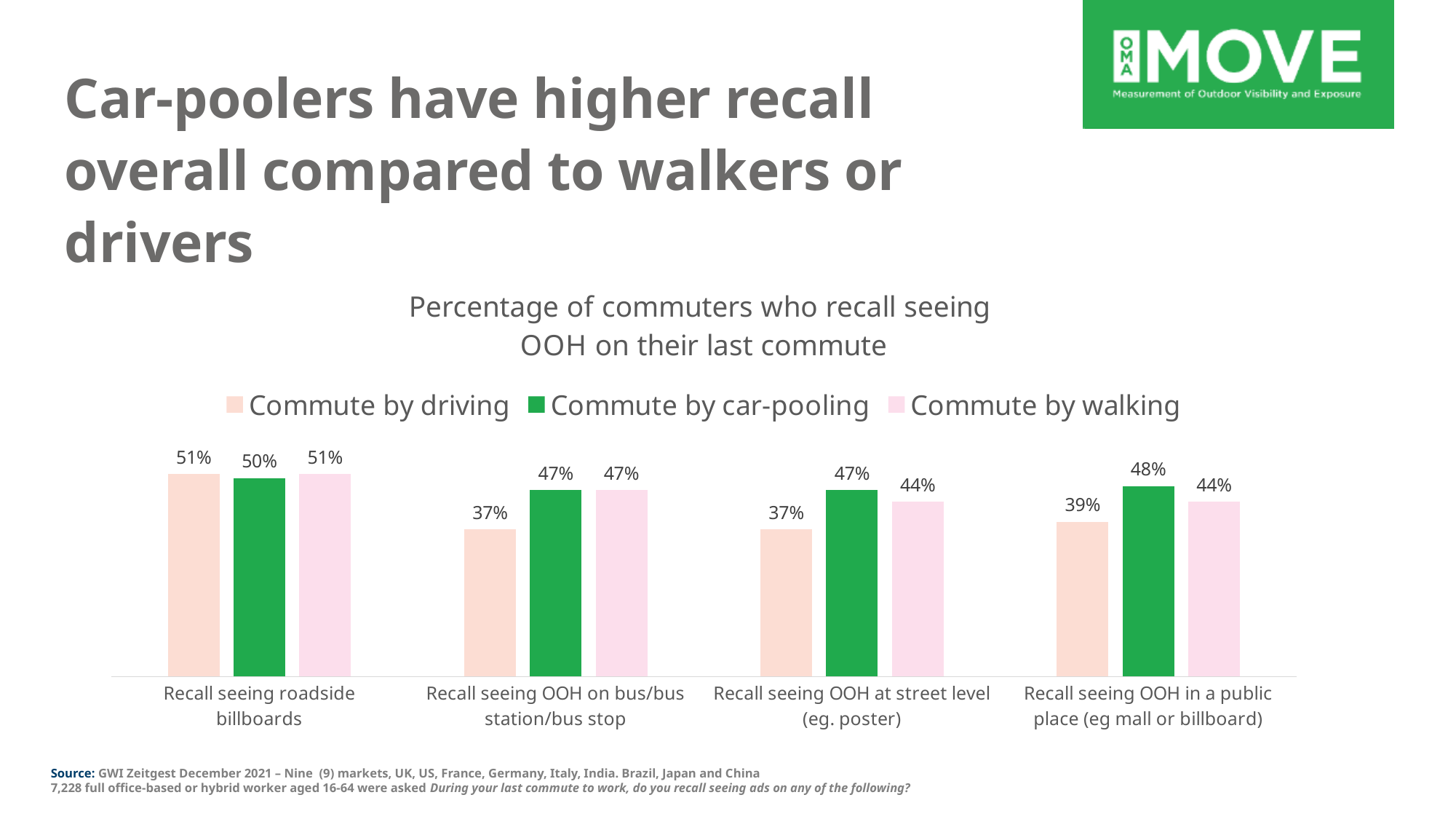
For Recall seeing OOH in a public place (eg mall or billboard), which is larger: Commute by car-pooling or Commute by walking? Commute by car-pooling What percentage of commuters who commute by car-pooling recall seeing OOH in a public place (eg mall or billboard)? 48% Which category has the highest value for Commute by walking? Recall seeing roadside billboards Which category has the lowest value for Commute by driving? Recall seeing OOH on bus/bus station/bus stop and Recall seeing OOH at street level (eg. poster) (both 37%) Which colour represents Commute by car-pooling in the legend? Green What percentage of commuters who commute by walking recall seeing OOH at street level (eg. poster)? 44% What percentage of commuters who commute by driving recall seeing OOH on bus/bus station/bus stop? 37% What is the title of the chart? Percentage of commuters who recall seeing OOH on their last commute How many categories are shown on the x axis? 4 How many series does the legend list? 3 What is the difference between Commute by car-pooling and Commute by driving for Recall seeing OOH at street level (eg. poster)? 10 percentage points What kind of chart is shown on the slide? Bar chart